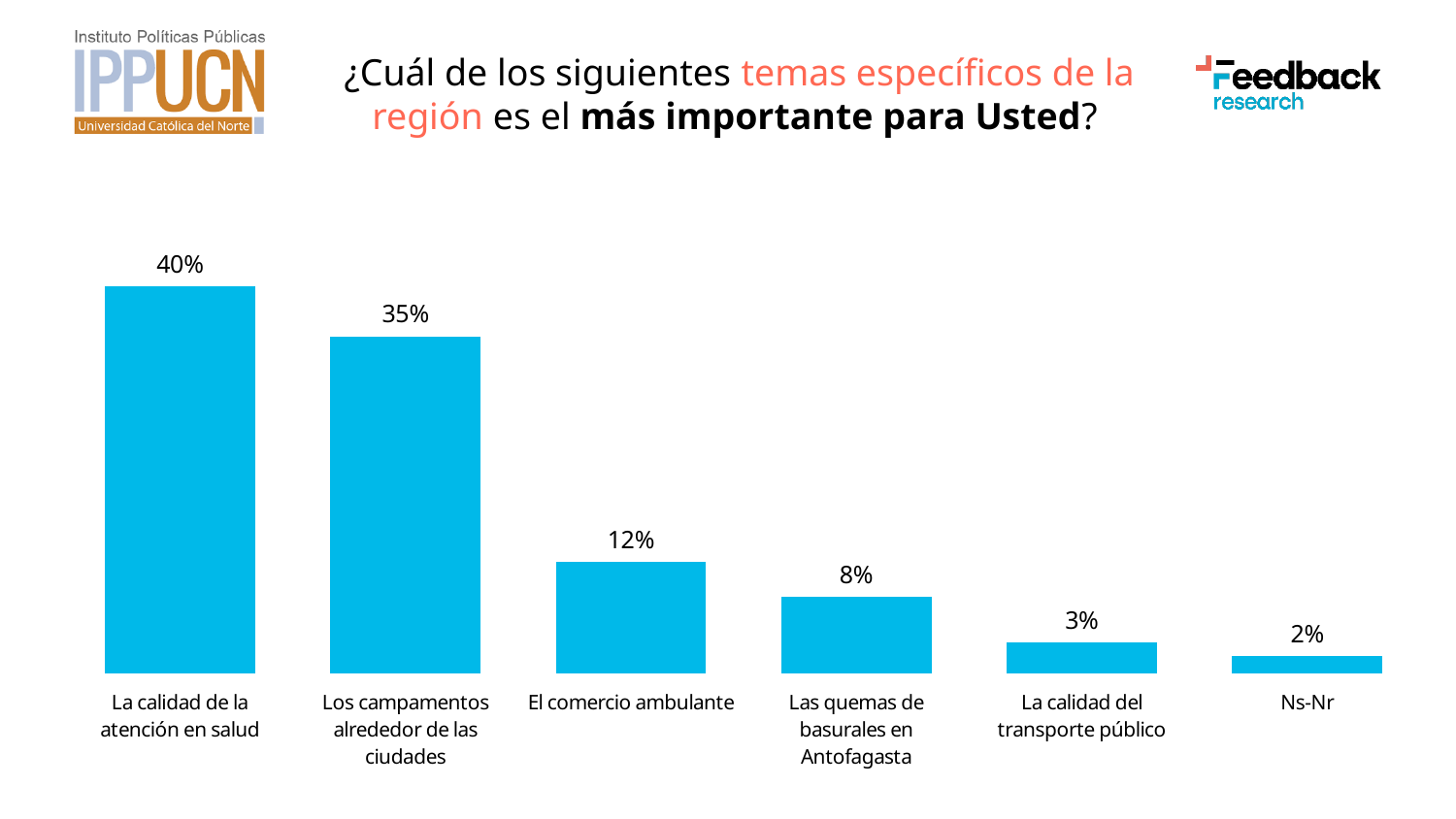
Which category has the lowest value? Ns-Nr What percentage of respondents chose 'La calidad de la atención en salud' as the most important topic? 40% What percentage is shown for 'Ns-Nr'? 2% Do the values rise or fall from left to right across the categories? Fall What is the value for 'Las quemas de basurales en Antofagasta'? 8% What is the difference between the values for 'La calidad de la atención en salud' and 'Los campamentos alrededor de las ciudades'? 5% What kind of chart is shown on the slide? Bar chart Which category has the highest value? La calidad de la atención en salud Which is larger: the value for 'El comercio ambulante' or for 'La calidad del transporte público'? El comercio ambulante What is the value shown for 'Los campamentos alrededor de las ciudades'? 35% How many categories are shown in the chart? 6 What percentage is shown for 'El comercio ambulante'? 12%